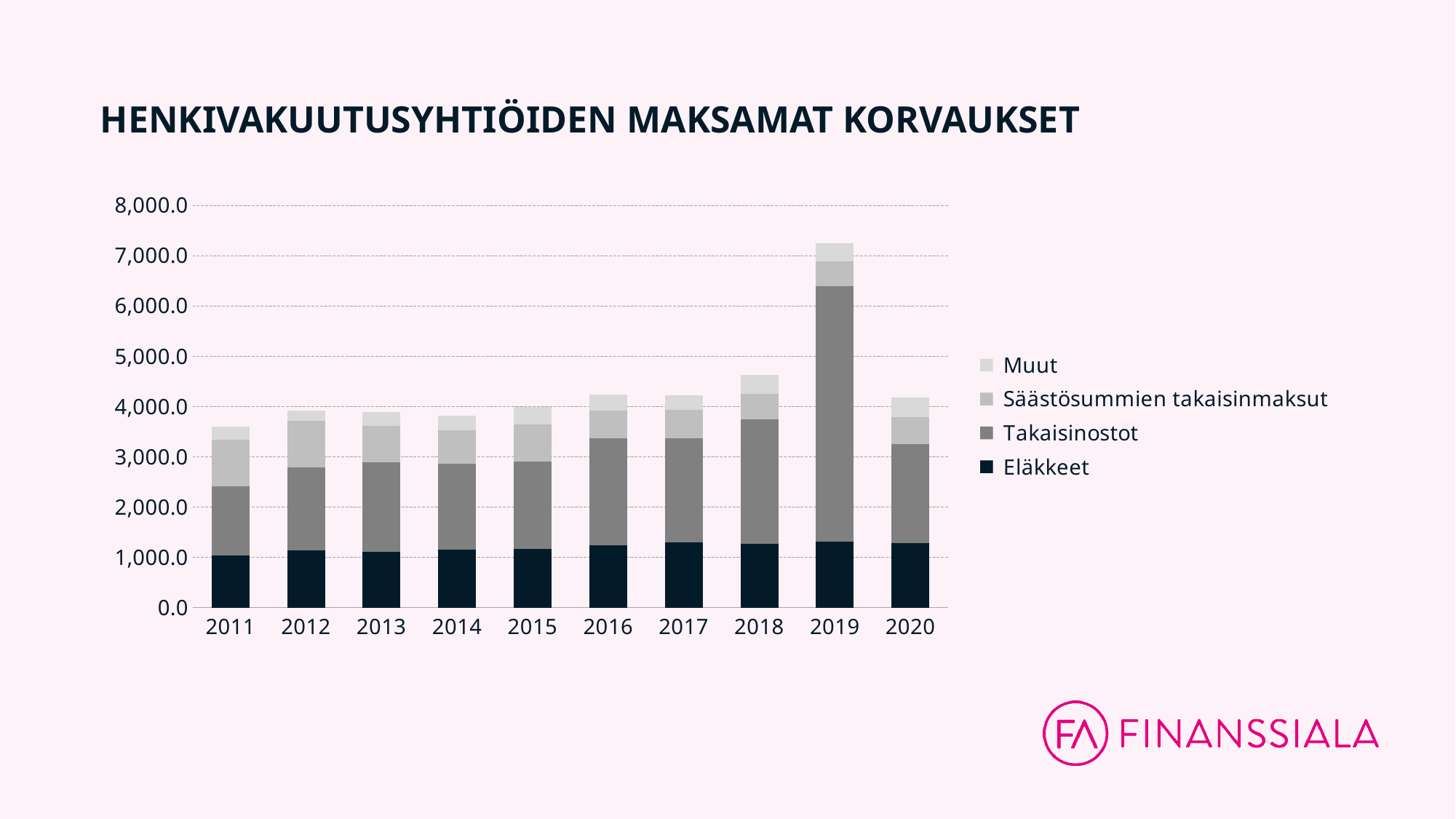
What kind of chart is shown on the slide? Stacked bar chart What is the title of the chart? HENKIVAKUUTUSYHTIÖIDEN MAKSAMAT KORVAUKSET Is the total bar for 2011 greater or less than 4,000.0? less Is the total bar for 2019 greater or less than 7,000.0? greater Is the total bar for 2019 larger or smaller than the total bar for 2018? larger How many years are shown on the x axis of the chart? 10 Which year has the lowest total bar in the chart? 2011 Does the total bar rise or fall from 2019 to 2020? fall How many series does the chart's legend list? 4 Is the total bar for 2018 greater or less than 4,000.0? greater Which series is shown at the bottom of each stacked bar? Eläkkeet Which year has the highest total bar in the chart? 2019